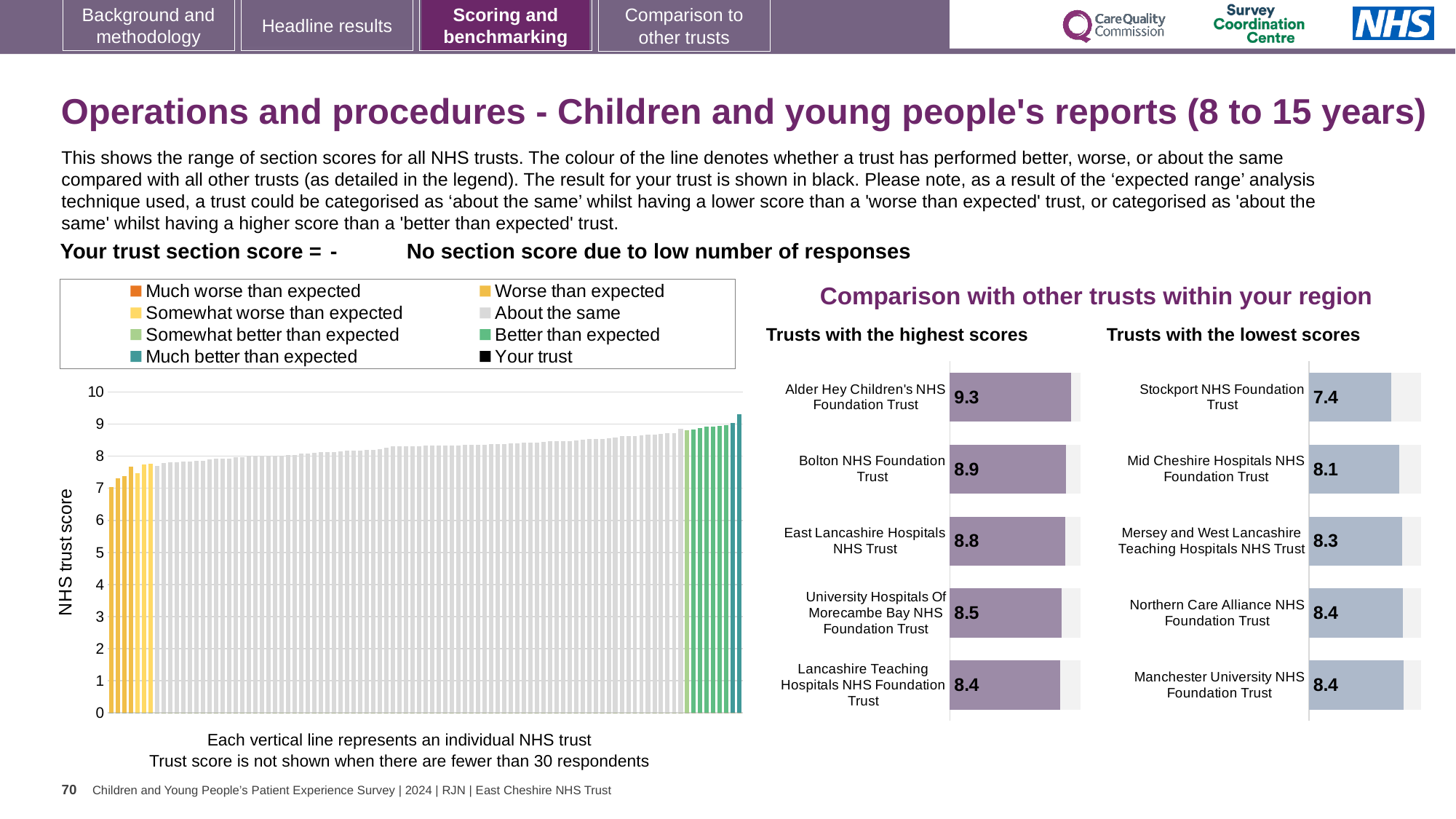
What kind of chart is the large chart on the left showing NHS trust scores? Bar chart In the 'Trusts with the lowest scores' chart, which trust has the lowest score? Stockport NHS Foundation Trust Which has the higher score: East Lancashire Hospitals NHS Trust in the 'highest scores' chart or Northern Care Alliance NHS Foundation Trust in the 'lowest scores' chart? East Lancashire Hospitals NHS Trust In the 'Trusts with the highest scores' chart, what is the score for Alder Hey Children's NHS Foundation Trust? 9.3 How many trusts are shown in the 'Trusts with the lowest scores' chart? 5 In the 'Trusts with the lowest scores' chart, what is the score for Stockport NHS Foundation Trust? 7.4 In the large chart on the left, do the NHS trust scores rise or fall from left to right? Rise In the 'Trusts with the highest scores' chart, what is the difference between the scores of Alder Hey Children's NHS Foundation Trust and Lancashire Teaching Hospitals NHS Foundation Trust? 0.9 In the 'Trusts with the lowest scores' chart, what is the score for Mersey and West Lancashire Teaching Hospitals NHS Trust? 8.3 In the 'Trusts with the highest scores' chart, what is the score for Bolton NHS Foundation Trust? 8.9 In the 'Trusts with the lowest scores' chart, what is the difference between the scores of Mid Cheshire Hospitals NHS Foundation Trust and Stockport NHS Foundation Trust? 0.7 In the 'Trusts with the highest scores' chart, which trust has the highest score? Alder Hey Children's NHS Foundation Trust